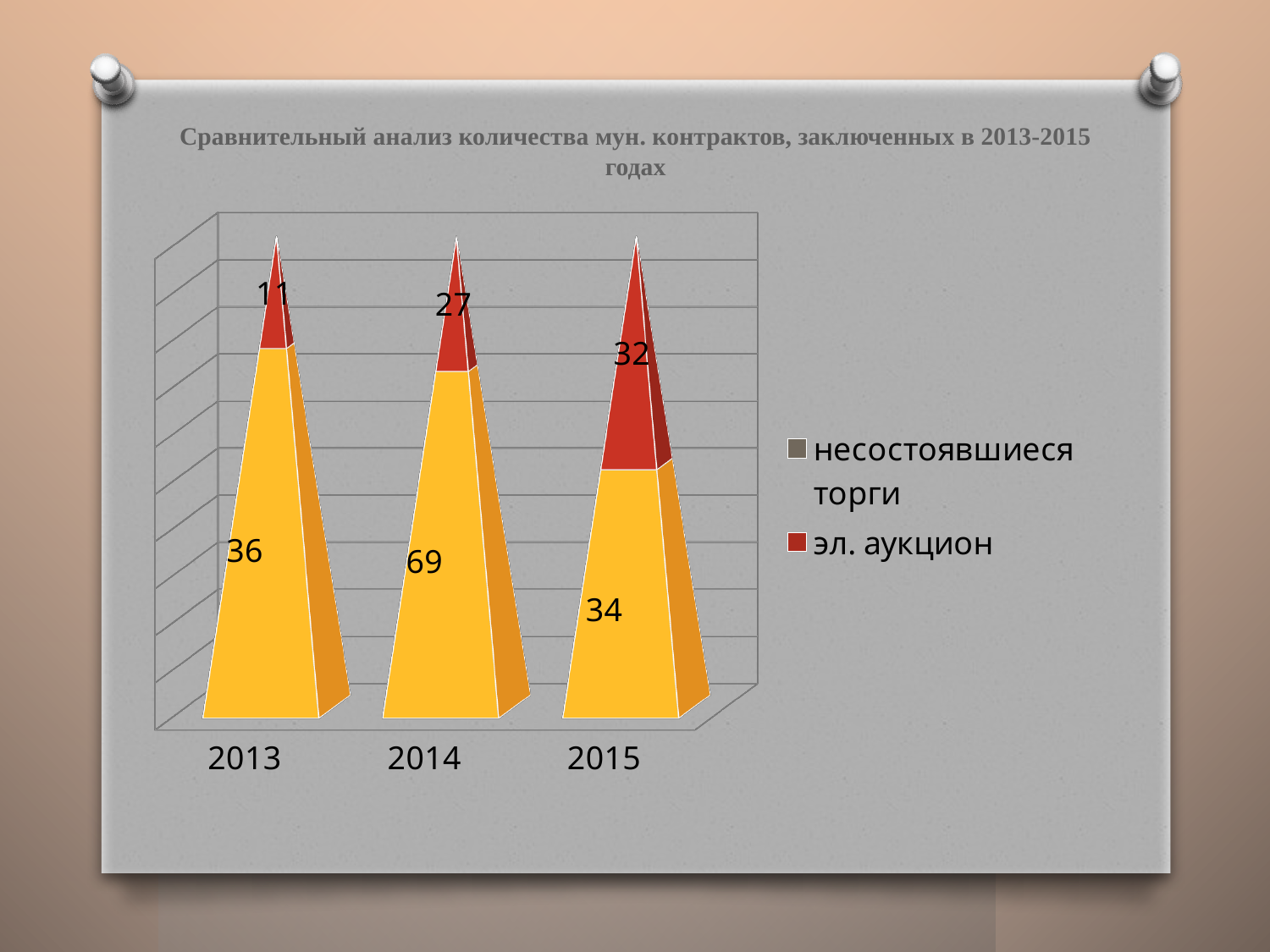
How many years are shown on the x axis? 3 What is the value of the эл. аукцион segment for 2015? 32 What is the total of the stacked bar for 2013? 47 What is the difference between the yellow segment values for 2014 and 2013? 33 How many series does the legend list? 2 Which year has the highest value for эл. аукцион? 2015 What is the value of the эл. аукцион segment for 2013? 11 Which year has the lowest value for the yellow (bottom) segment? 2015 What is the value of the yellow (bottom) segment for 2014? 69 Do the values for эл. аукцион rise or fall from 2013 to 2015? rise What kind of chart is shown on the slide? stacked bar chart What is the total of the stacked bar for 2014? 96